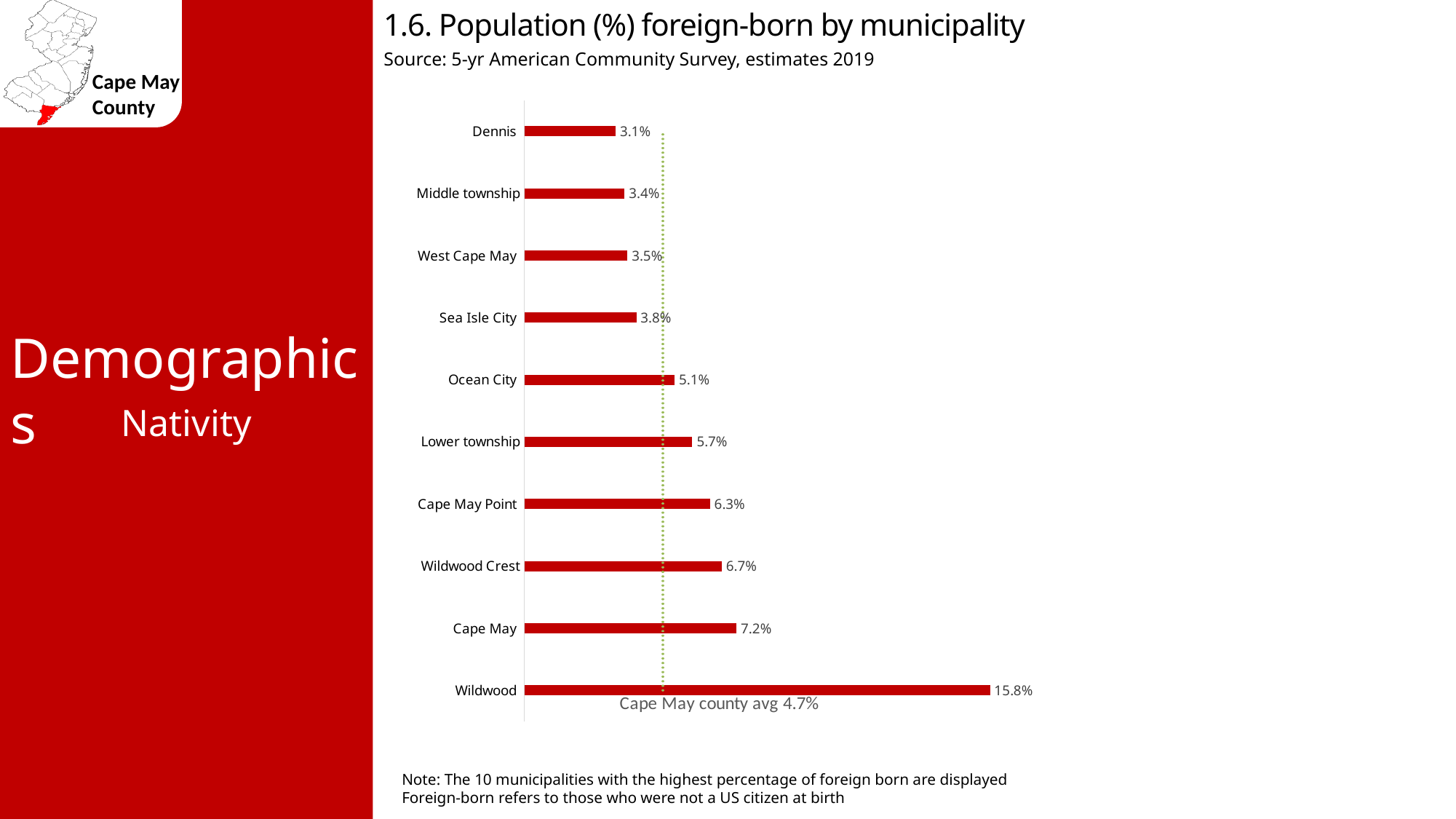
What is the Cape May county average percentage of foreign-born population shown by the dotted line? 4.7% What is the percentage of foreign-born population for Ocean City? 5.1% What is the percentage of foreign-born population for Wildwood? 15.8% What type of chart is used to show the foreign-born population by municipality? Bar chart Which municipality has the highest percentage of foreign-born population? Wildwood How many municipalities are shown in the chart? 10 What is the difference in percentage points between Wildwood and Cape May? 8.6 Which municipality has the lowest percentage of foreign-born population? Dennis What is the percentage of foreign-born population for Middle township? 3.4% What is the difference in percentage points between Cape May Point and Sea Isle City? 2.5 Which has a higher percentage of foreign-born population, Wildwood Crest or Lower township? Wildwood Crest What is the source of the data shown in the chart? 5-yr American Community Survey, estimates 2019